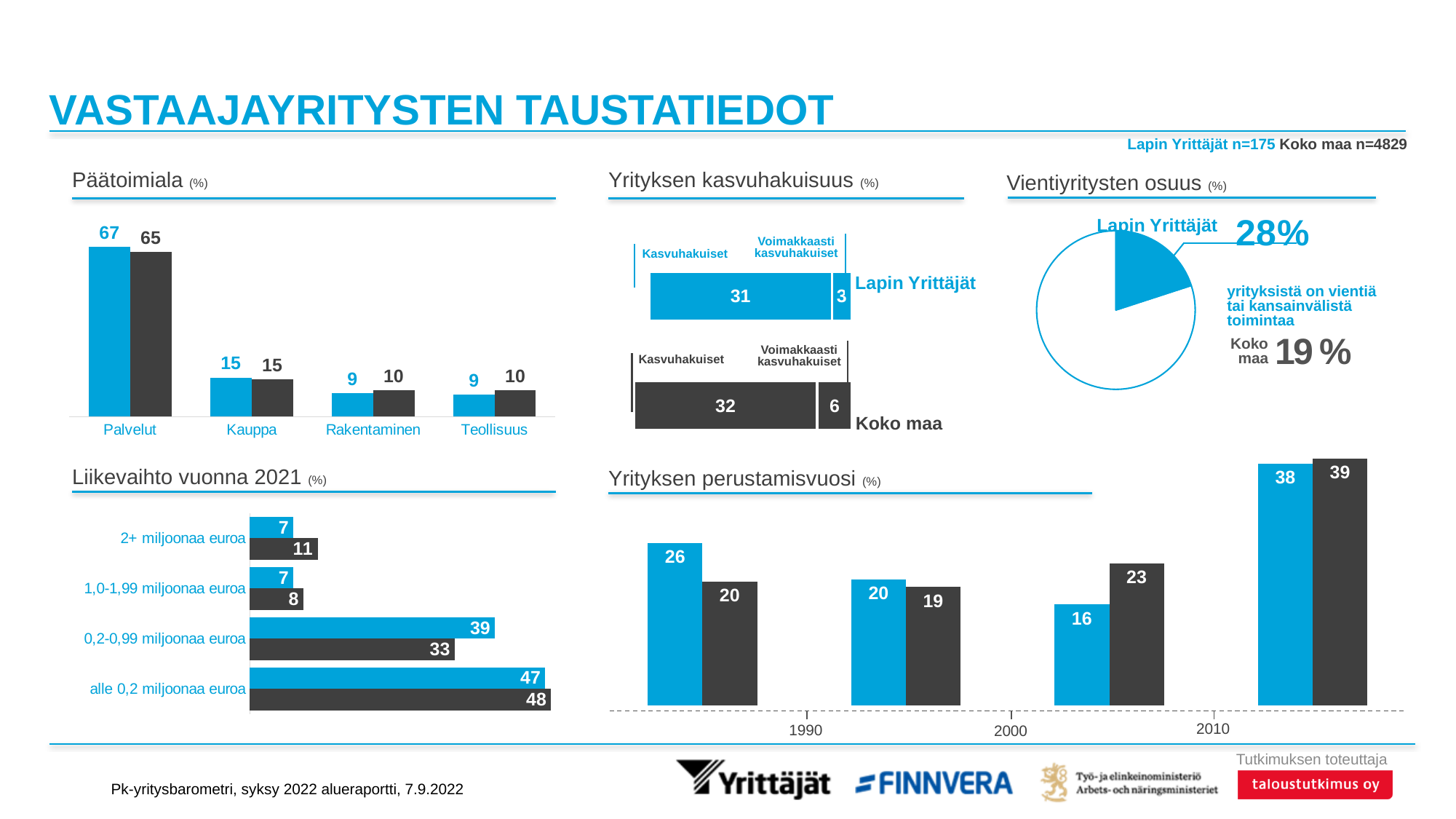
In the "Liikevaihto vuonna 2021" chart, which category has the lowest Lapin Yrittäjät (blue) value? 2+ miljoonaa euroa and 1,0-1,99 miljoonaa euroa (both 7) What kind of chart is "Liikevaihto vuonna 2021"? Bar chart In the "Liikevaihto vuonna 2021" chart, what is the Koko maa (dark bar) value for "alle 0,2 miljoonaa euroa"? 48 In the "Yrityksen perustamisvuosi" chart, which is larger for the first (leftmost) period: the Lapin Yrittäjät value or the Koko maa value? Lapin Yrittäjät (26) In the "Yrityksen kasvuhakuisuus" chart, what is the Voimakkaasti kasvuhakuiset value for Koko maa? 6 In the "Päätoimiala" chart, what is the value for Palvelut for Lapin Yrittäjät (blue bar)? 67 In the "Päätoimiala" chart, what is the difference between the Palvelut values for Lapin Yrittäjät (67) and Koko maa (65)? 2 In the "Päätoimiala" chart, how many categories are shown on the x axis? 4 In the "Vientiyritysten osuus" chart, what is the value for Koko maa? 19 % In the "Vientiyritysten osuus" pie chart, what share of Lapin Yrittäjät companies have export or international activity? 28% In the "Päätoimiala" chart, which category has the highest values? Palvelut In the "Yrityksen kasvuhakuisuus" chart, what is the total of the Lapin Yrittäjät stacked bar (Kasvuhakuiset 31 plus Voimakkaasti kasvuhakuiset 3)? 34